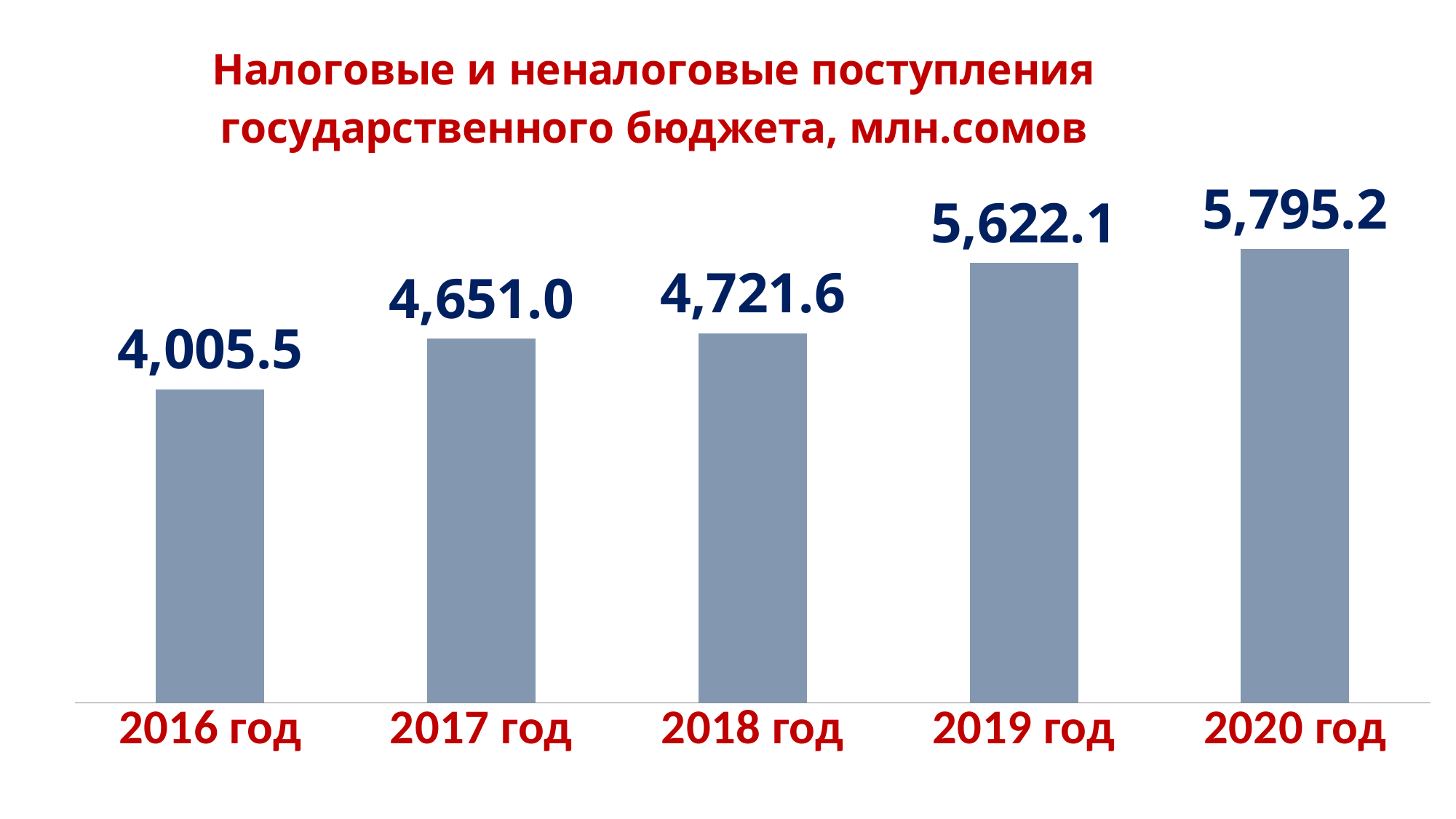
Which year has the lowest value? 2016 год What is the value for 2016 год? 4,005.5 What is the difference between the values for 2020 год and 2019 год? 173.1 What is the value for 2018 год? 4,721.6 What is the value for 2020 год? 5,795.2 How many years are shown on the chart? 5 Which is larger, the value for 2018 год or the value for 2017 год? 2018 год Which year has the highest value? 2020 год What is the difference between the values for 2017 год and 2016 год? 645.5 Do the values rise or fall from 2016 год to 2020 год? rise What is the title of the chart? Налоговые и неналоговые поступления государственного бюджета, млн.сомов What kind of chart is this? bar chart